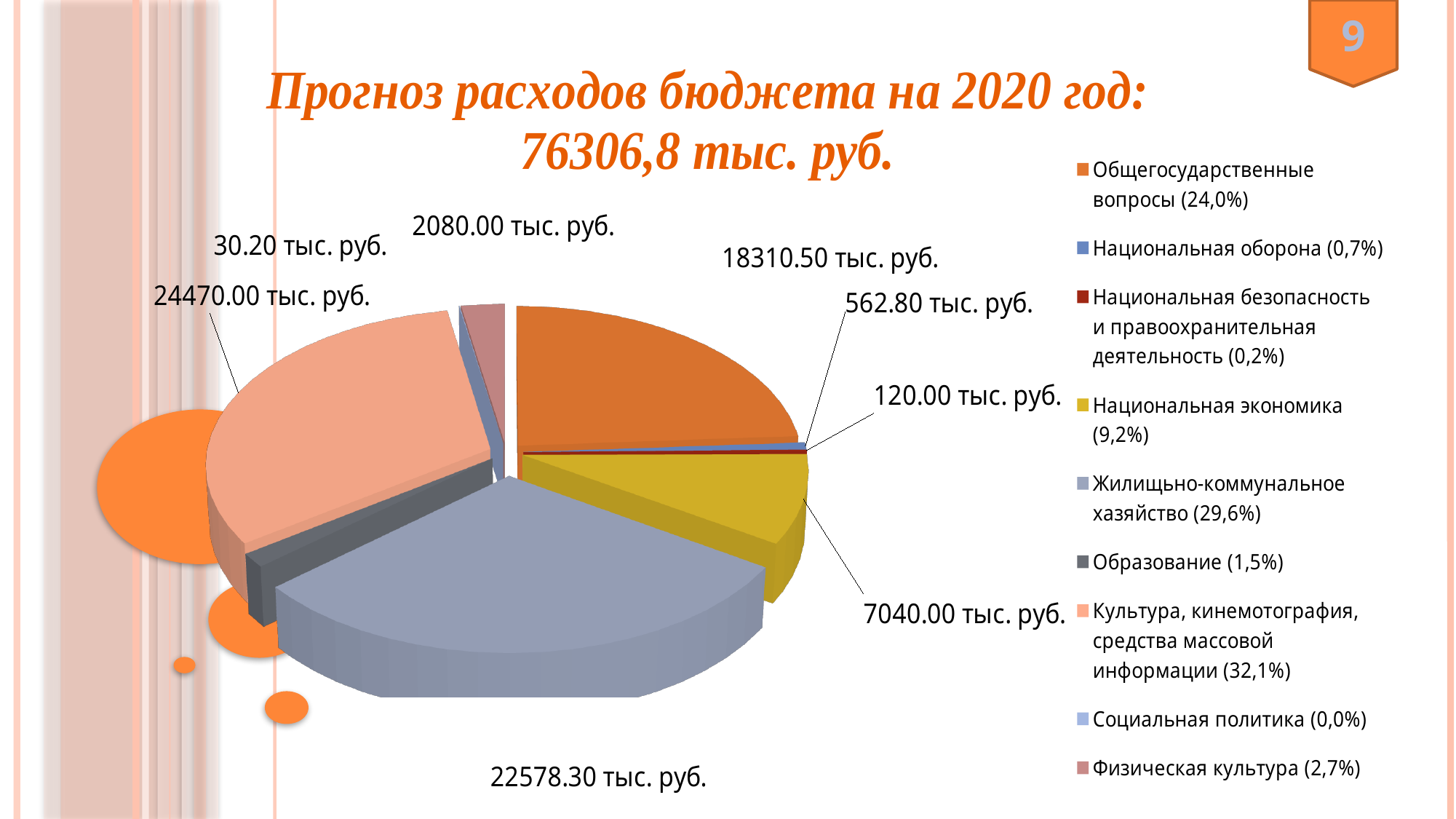
What is the smallest value printed as a data label on the pie chart? 30.20 тыс. руб. What share of the budget does Национальная экономика have? 9,2% Which category has the smallest share of the budget according to the legend? Социальная политика (0,0%) What share of the budget does Общегосударственные вопросы have? 24,0% What kind of chart is shown on the slide? pie chart Which has a larger share: Общегосударственные вопросы or Национальная экономика? Общегосударственные вопросы What share of the budget does Жилищно-коммунальное хозяйство have? 29,6% What total budget expenditure for 2020 is stated in the chart title? 76306,8 тыс. руб. Which category has the largest share of the budget according to the legend? Культура, кинемотография, средства массовой информации (32,1%) How many categories does the legend of the pie chart list? 9 What is the largest value printed as a data label on the pie chart? 24470.00 тыс. руб.